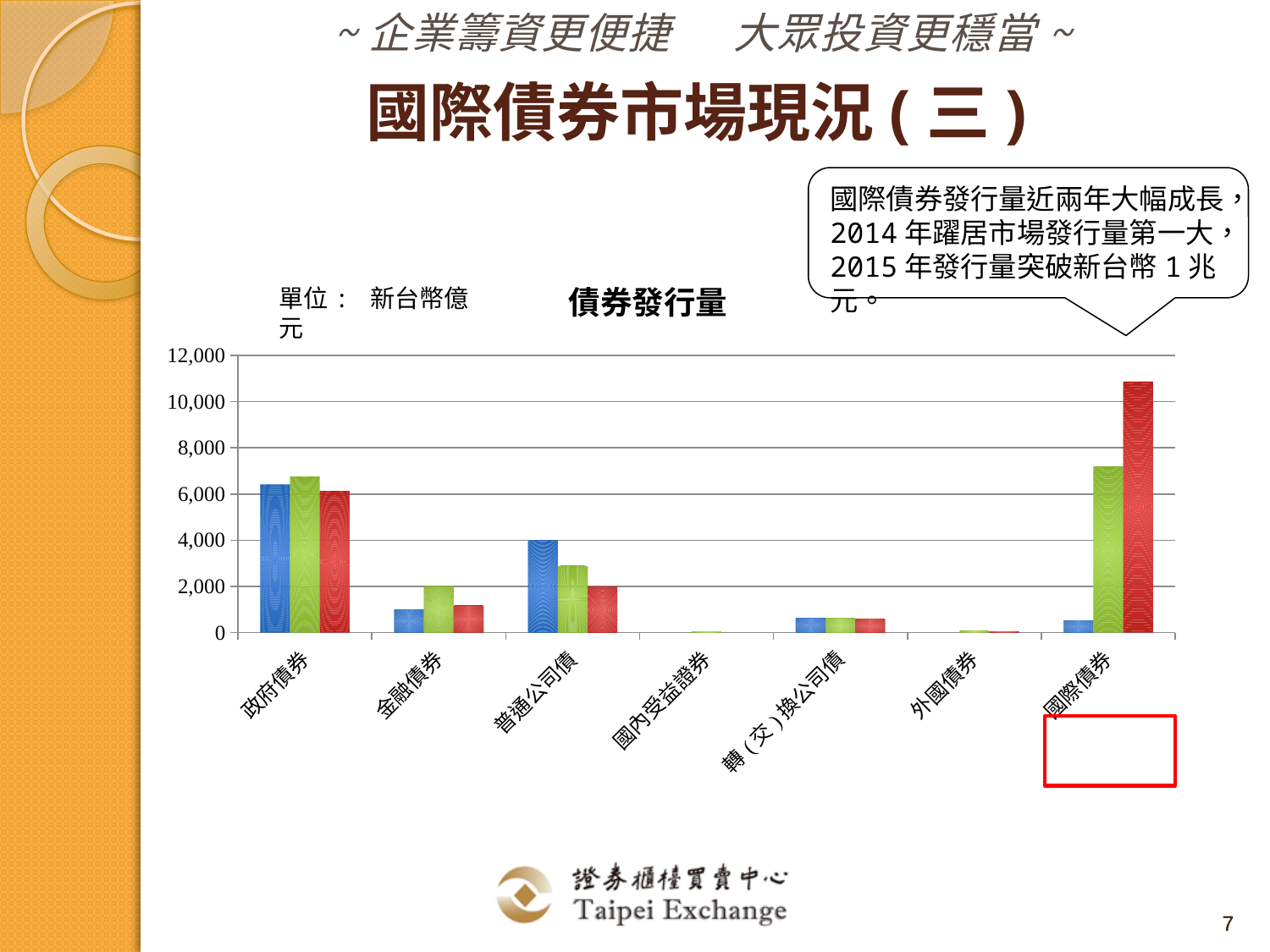
How many bars are plotted for each category in the chart? 3 What kind of chart is shown on the slide? bar chart Which category has the tallest bar in the chart? 國際債券 Which is larger: the blue bar for 政府債券 or the blue bar for 國際債券? 政府債券 What is the title of the chart? 債券發行量 Which is larger: the red bar for 國際債券 or the red bar for 政府債券? 國際債券 Is the value of the green bar for 普通公司債 greater or less than 4,000? less Is the value of the red bar for 國際債券 greater or less than 10,000? greater Is the value of the green bar for 國際債券 greater or less than 6,000? greater How many categories are shown on the x axis of the chart? 7 Which category has the tallest blue bar in the chart? 政府債券